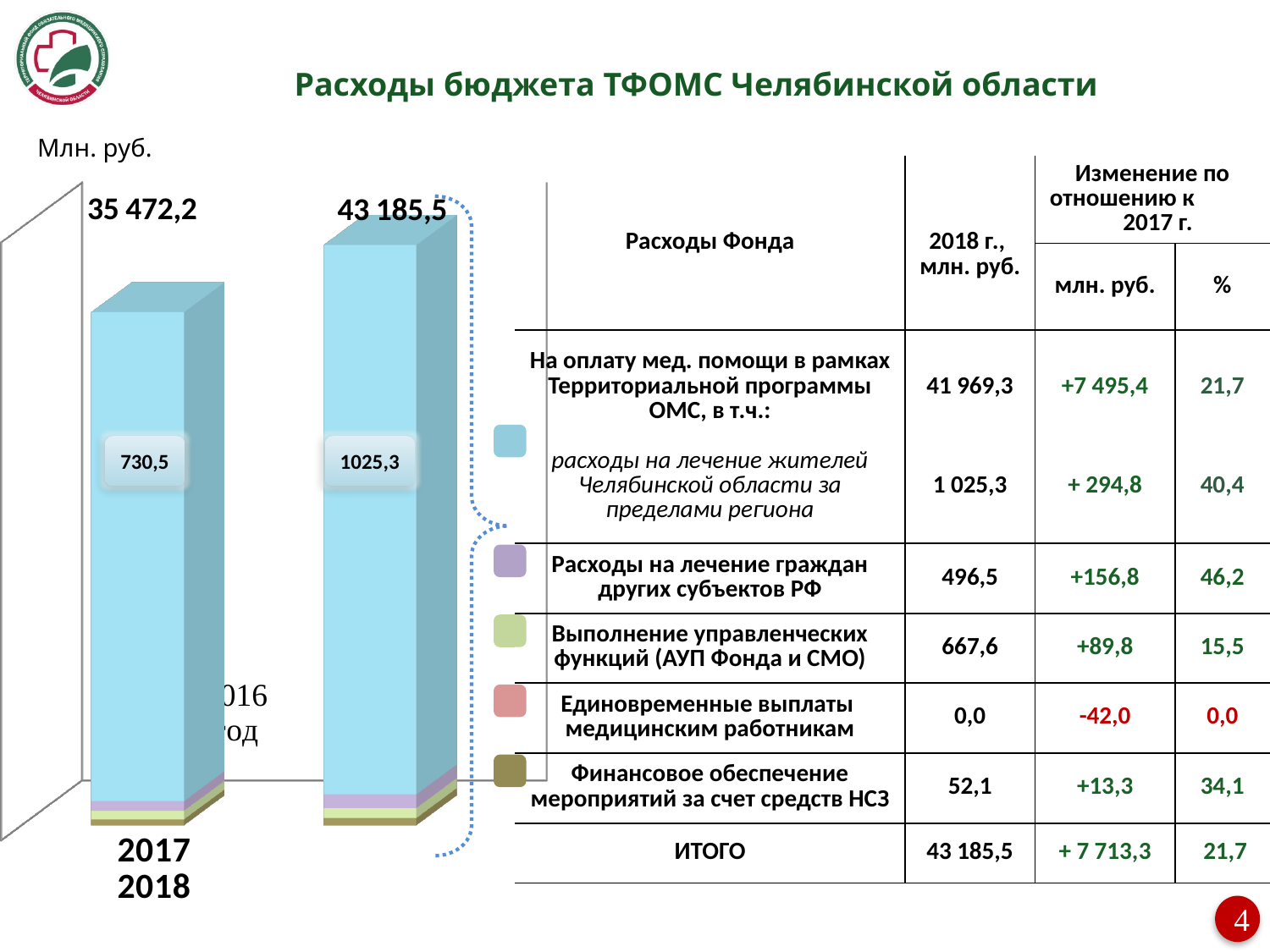
Which year has the higher total bar value? 2018 What kind of chart is shown on the slide? bar chart Which year has the lower total bar value? 2017 What is the total value shown above the 2018 bar? 43 185,5 How many bars (years) are plotted in the chart? 2 What value is printed inside the large light-blue segment of the 2017 bar? 730,5 What is the difference between the values printed inside the bars, 1025,3 for 2018 and 730,5 for 2017? 294,8 What value is printed inside the large light-blue segment of the 2018 bar? 1025,3 What is the total value shown above the 2017 bar? 35 472,2 Do the total bar values rise or fall from 2017 to 2018? rise Is the value printed inside the 2018 bar larger or smaller than the value printed inside the 2017 bar? larger By how much does the 2018 total (43 185,5) exceed the 2017 total (35 472,2)? 7 713,3